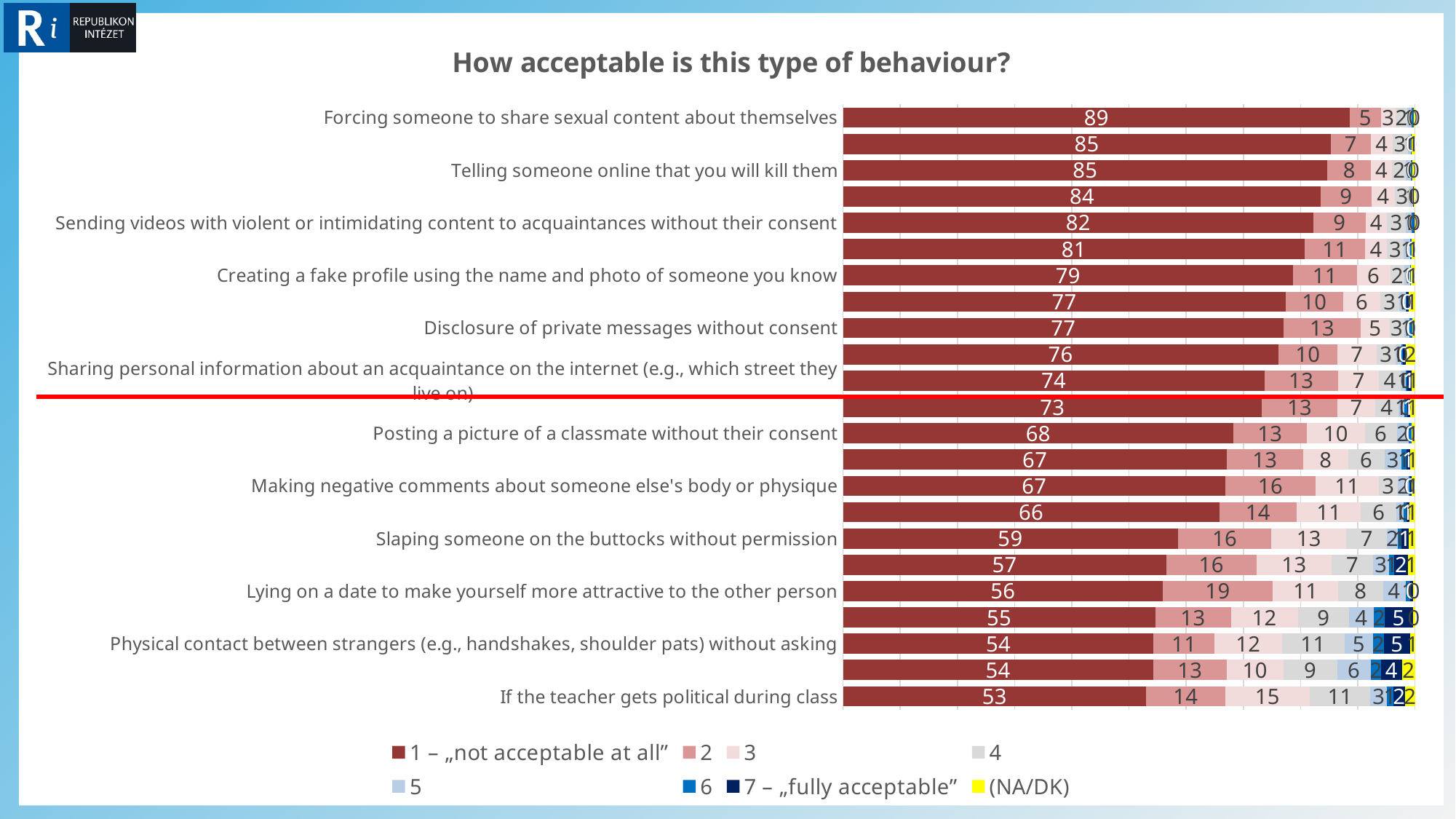
What is the difference between the 1 – "not acceptable at all" values for "Forcing someone to share sexual content about themselves" and "If the teacher gets political during class"? 36 What is the value of the 1 – "not acceptable at all" segment for "If the teacher gets political during class"? 53 Which labelled behaviour has the highest share of 1 – "not acceptable at all" responses? Forcing someone to share sexual content about themselves What type of chart is shown on the slide? Stacked bar chart What is the title of the chart? How acceptable is this type of behaviour? What is the value of the "3" segment for "If the teacher gets political during class"? 15 How many series does the legend list? 8 What is the value of the 7 – "fully acceptable" segment for "Physical contact between strangers (e.g., handshakes, shoulder pats) without asking"? 5 What percentage of respondents rated "Forcing someone to share sexual content about themselves" as 1 – "not acceptable at all"? 89 Which has a larger 1 – "not acceptable at all" value: "Telling someone online that you will kill them" or "Creating a fake profile using the name and photo of someone you know"? Telling someone online that you will kill them Which labelled behaviour has the lowest share of 1 – "not acceptable at all" responses? If the teacher gets political during class What is the value of the "2" segment for "Lying on a date to make yourself more attractive to the other person"? 19